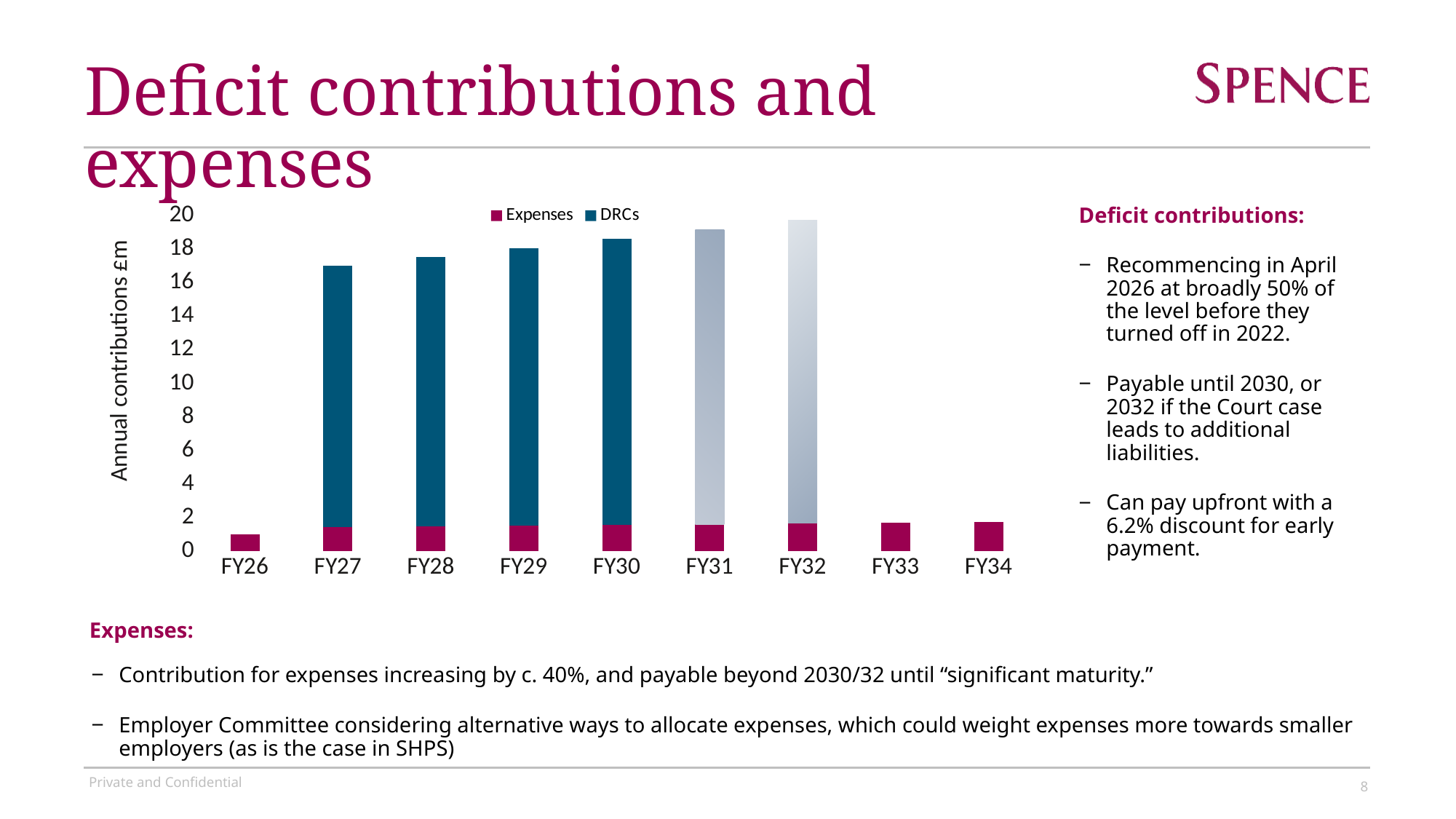
What kind of chart is shown on the slide? Stacked bar chart How many fiscal years are shown on the x axis of the chart? 9 How many series does the chart legend list? 2 What are the two series named in the chart legend? Expenses and DRCs Is the total bar for FY27 greater or less than 16? greater Do the total bars rise or fall from FY27 to FY32? rise What is the title of the vertical axis of the chart? Annual contributions £m Is the value for FY26 greater or less than 2? less Which fiscal year has the tallest total bar in the chart? FY32 Which has the larger total bar, FY27 or FY30? FY30 Which fiscal year has the shortest total bar in the chart? FY26 Is the total bar for FY32 greater or less than 18? greater